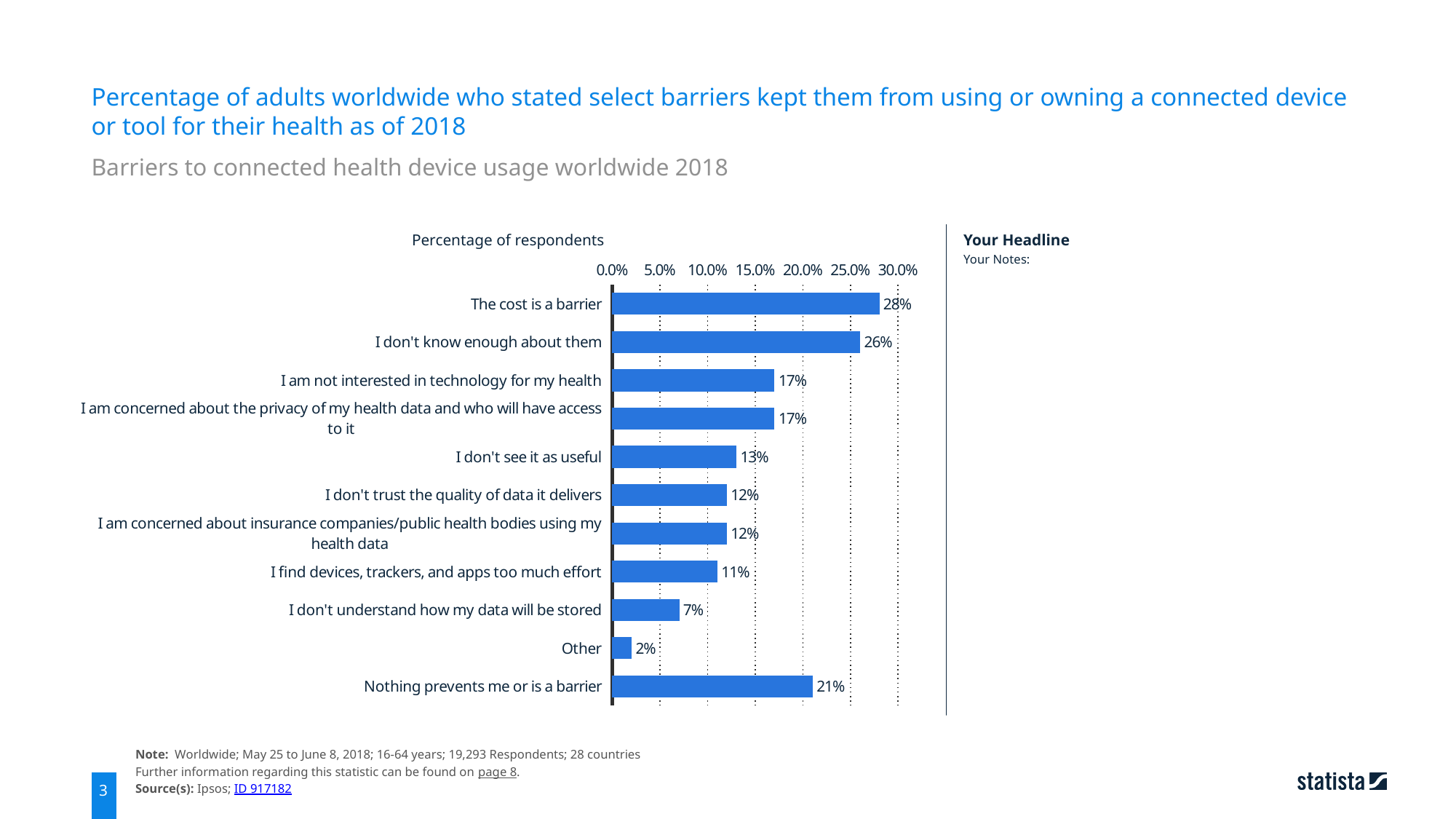
What percentage of respondents said 'Nothing prevents me or is a barrier'? 21% What percentage of respondents said 'I don't understand how my data will be stored'? 7% How many categories are shown in the chart? 11 Which barrier has the highest percentage of respondents? The cost is a barrier What is the difference in percentage points between 'The cost is a barrier' and 'I don't know enough about them'? 2 Which has a higher percentage: 'I don't see it as useful' or 'I find devices, trackers, and apps too much effort'? I don't see it as useful Is the value for 'I am not interested in technology for my health' greater or less than 15.0%? greater What is the difference in percentage points between 'I don't trust the quality of data it delivers' and 'Other'? 10 What percentage of respondents stated that cost is a barrier? 28% What kind of chart is shown on the slide? Bar chart What is the label of the value axis of the chart? Percentage of respondents Which category has the lowest percentage of respondents? Other